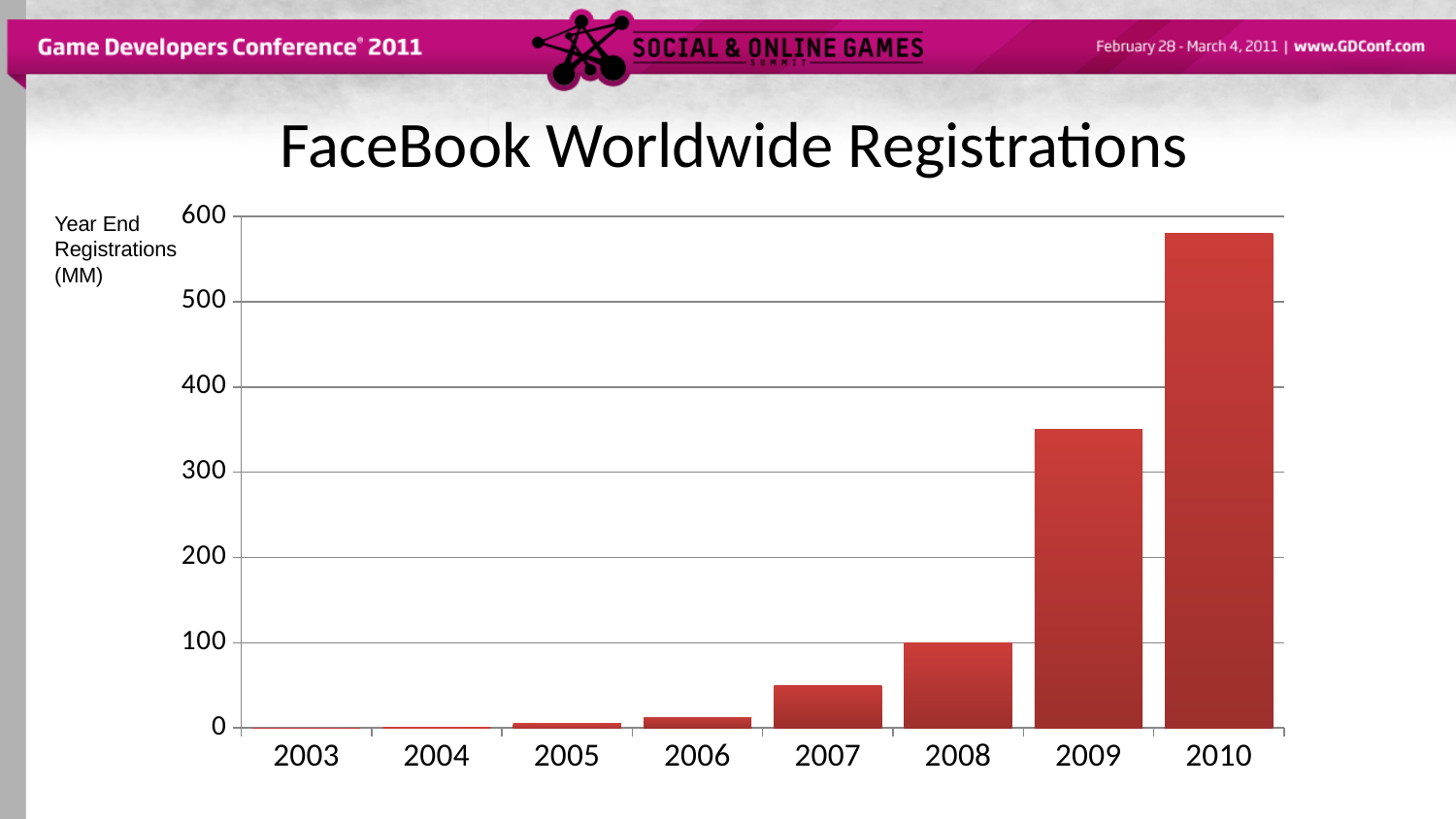
Is the value for 2009 greater or less than 400? less Which year has the highest year-end registrations? 2010 Is the value for 2007 greater or less than 100? less Do the registrations rise or fall from 2003 to 2010? rise What is the year-end registrations value for 2008? 100 What is the label on the vertical axis of the chart? Year End Registrations (MM) Is the value for 2010 greater or less than 500? greater What is the title of the chart? FaceBook Worldwide Registrations Which year has the larger value, 2008 or 2009? 2009 What type of chart is shown on the slide? bar chart How many years are shown on the x axis of the chart? 8